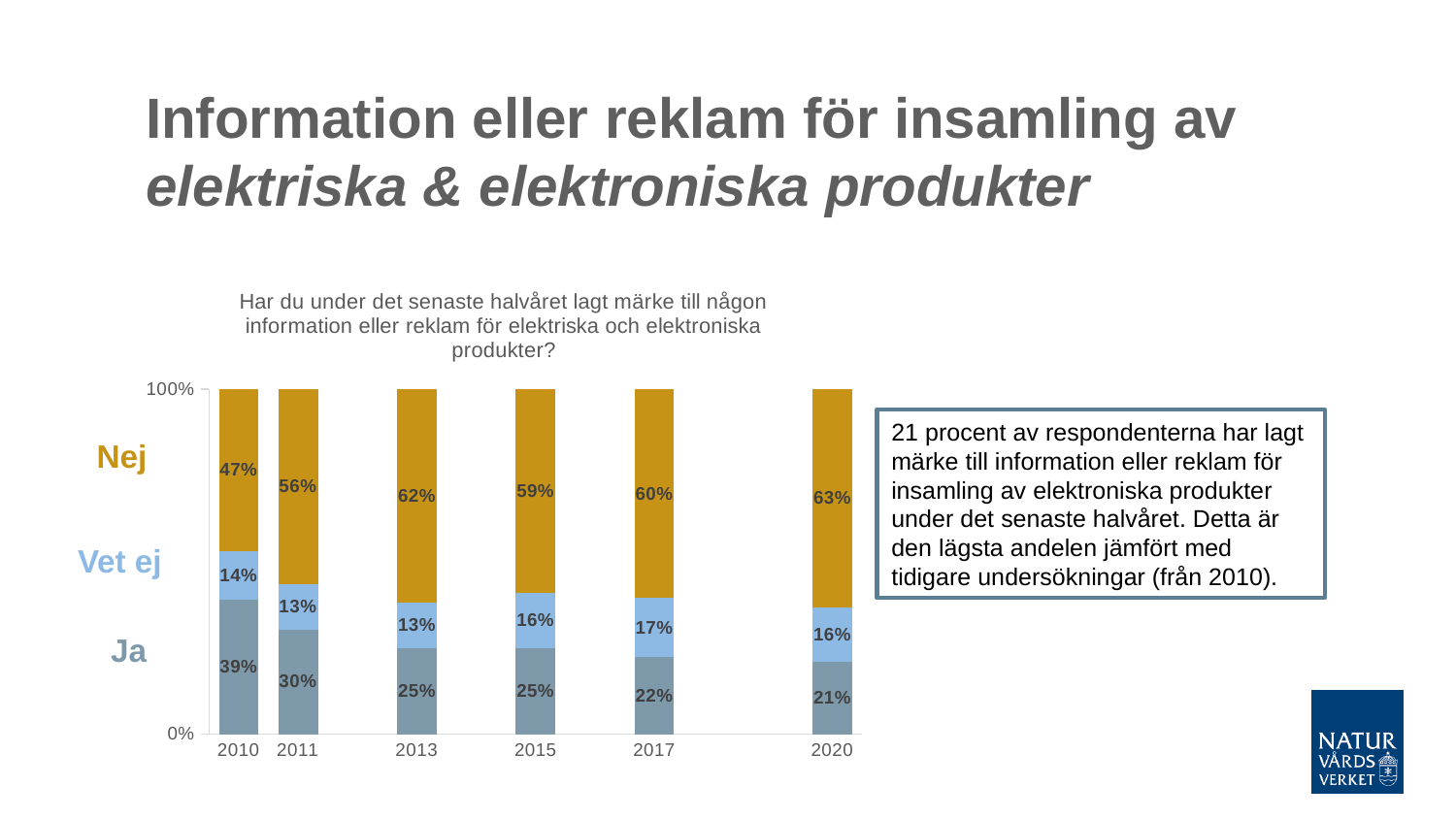
In which year is the "Ja" share highest? 2010 How many years are shown on the x axis? 6 Which series is shown in gold/yellow? Nej How many series are shown in the stacked bars? 3 What is the value for "Ja" in 2020? 21% What is the value for "Nej" in 2013? 62% What is the value for "Vet ej" in 2017? 17% Does the "Ja" share rise or fall from 2010 to 2020? Fall What kind of chart is shown on the slide? Stacked bar chart In which year is the "Nej" share lowest? 2010 What is the difference between the "Ja" value in 2010 and the "Ja" value in 2020? 18 percentage points Which is larger, the "Nej" value in 2011 or the "Nej" value in 2015? 2015